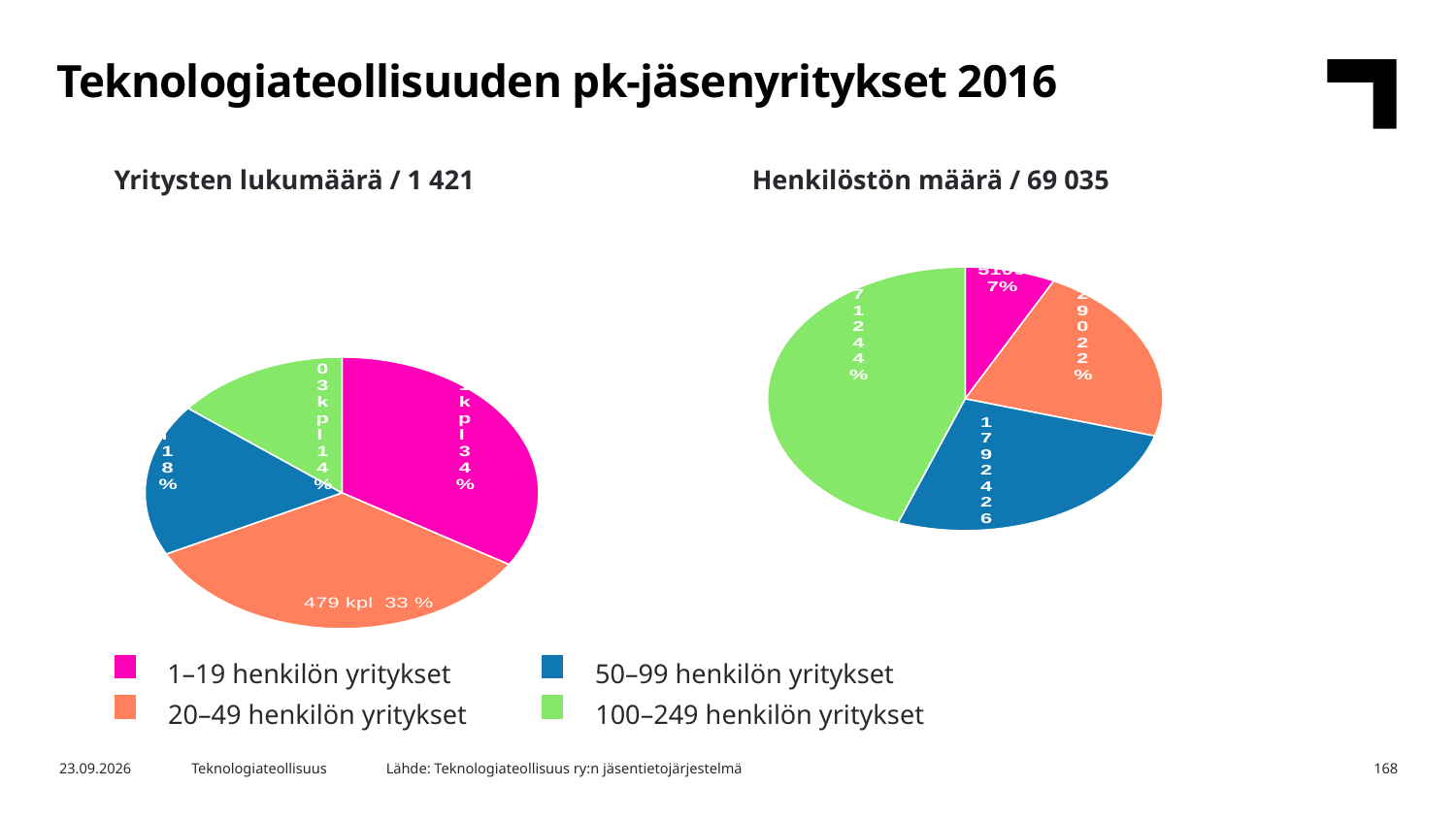
In the 'Henkilöstön määrä / 69 035' chart, which category has the largest slice? 100–249 henkilön yritykset How many categories does the legend list for the pie charts? 4 In the 'Yritysten lukumäärä / 1 421' chart, what share of the pie do the 100–249 henkilön yritykset have? 14 % In the 'Yritysten lukumäärä / 1 421' chart, how many companies (kpl) are in the 20–49 henkilön yritykset slice? 479 kpl In the 'Henkilöstön määrä / 69 035' chart, what share of the pie do the 1–19 henkilön yritykset have? 7% In the 'Yritysten lukumäärä / 1 421' chart, what is the difference in percentage share between the 1–19 henkilön yritykset and the 100–249 henkilön yritykset slices? 20 % In the 'Yritysten lukumäärä / 1 421' chart, what share of the pie do the 50–99 henkilön yritykset have? 18 % What kind of chart is used on this slide for 'Yritysten lukumäärä / 1 421'? Pie chart In the 'Yritysten lukumäärä / 1 421' chart, which category has the smallest slice? 100–249 henkilön yritykset In the 'Yritysten lukumäärä / 1 421' chart, which slice is larger: 50–99 henkilön yritykset or 100–249 henkilön yritykset? 50–99 henkilön yritykset